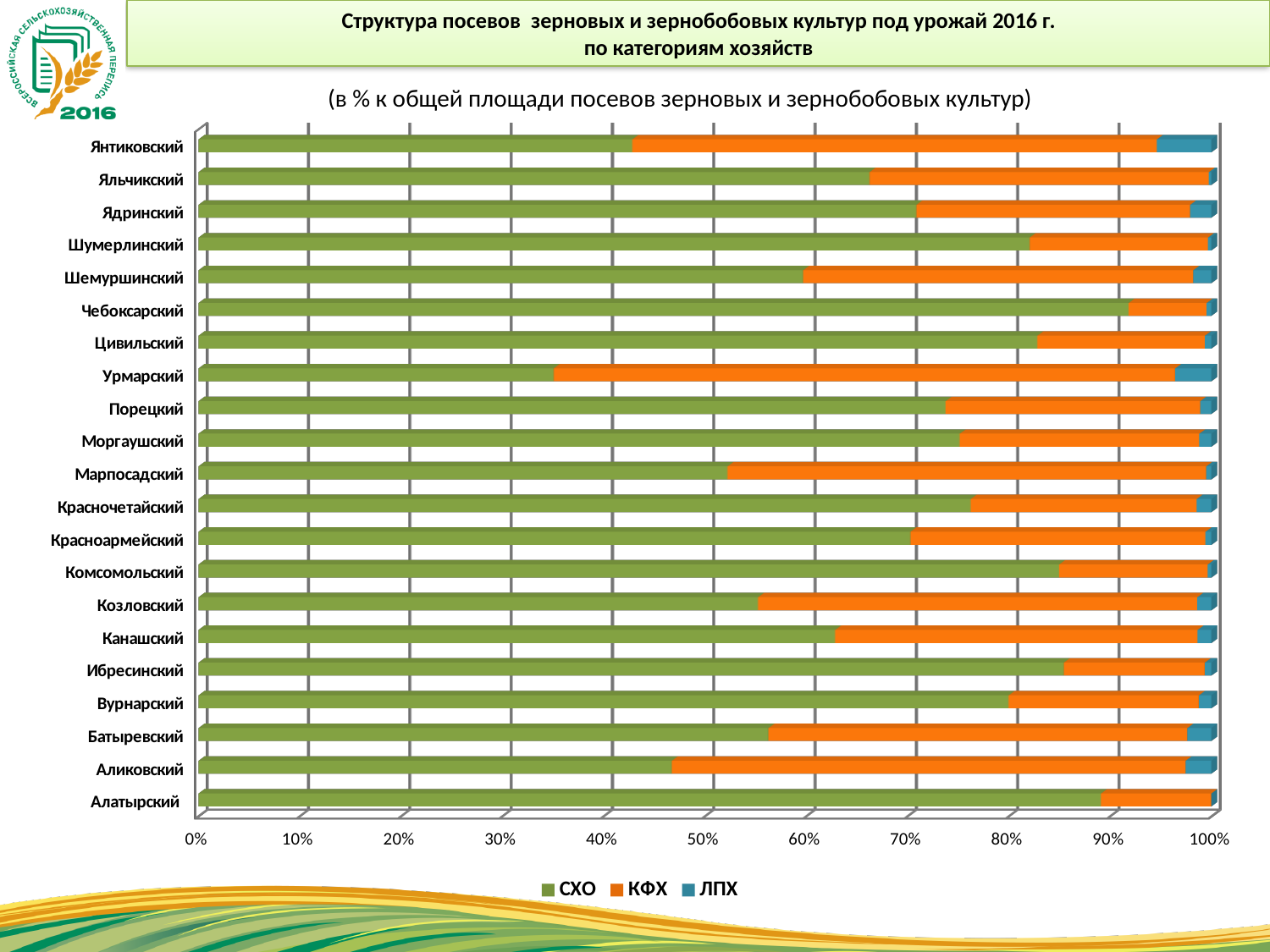
Which district has the lowest share for СХО? Урмарский Which district has the larger СХО share, Урмарский or Марпосадский? Марпосадский Is the СХО share for Янтиковский greater or less than 50%? less How many districts (categories) are listed on the vertical axis of the chart? 21 Which district has the highest share for СХО? Чебоксарский Which district has the larger СХО share, Аликовский or Алатырский? Алатырский What kind of chart is shown on the slide? Stacked bar chart How many series does the chart legend list? 3 Which district has the largest share for КФХ? Урмарский Is the СХО share for Урмарский greater or less than 40%? less Is the СХО share for Чебоксарский greater or less than 90%? greater What are the three series named in the chart legend? СХО, КФХ, ЛПХ